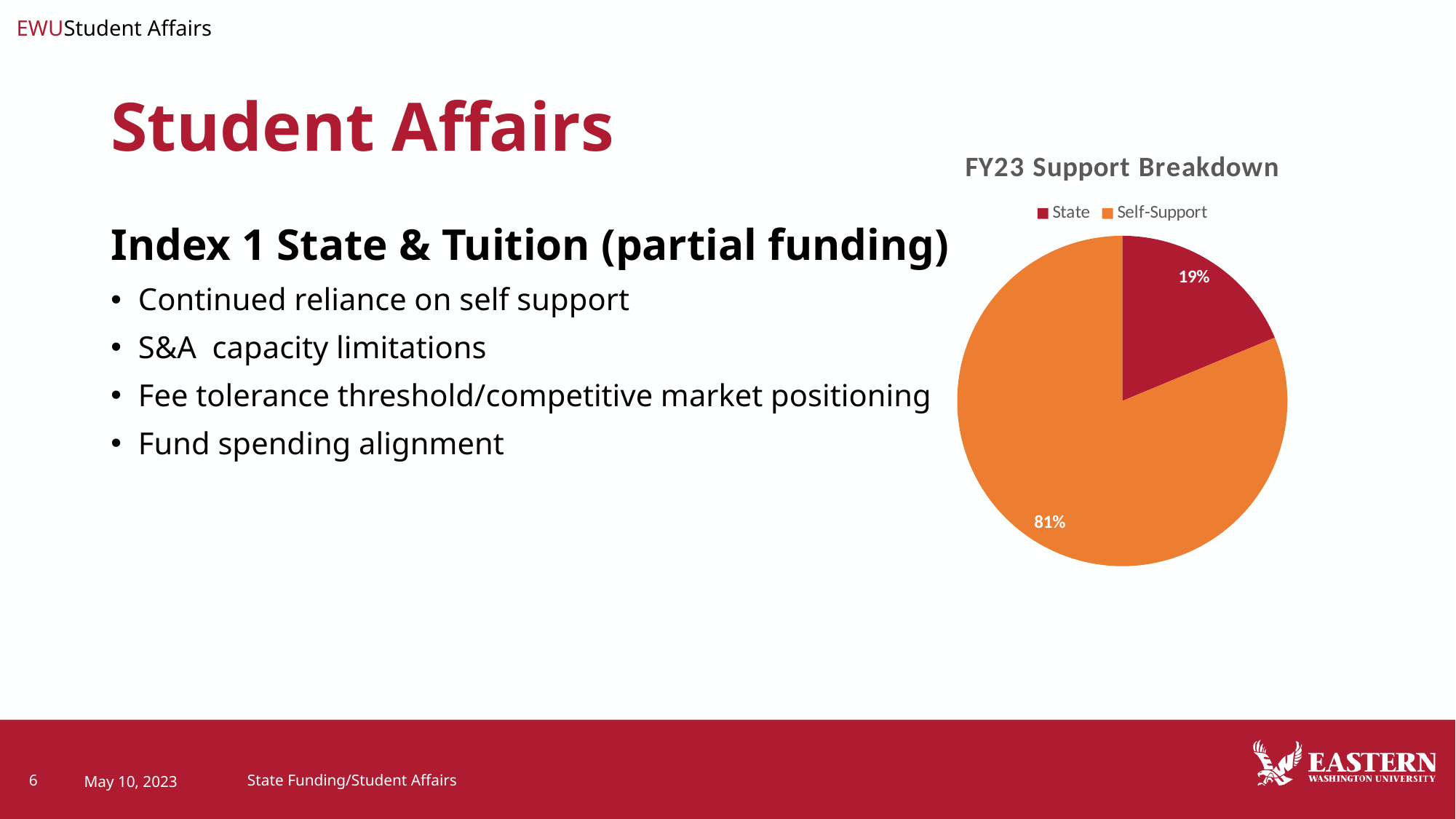
How many entries does the legend of the pie chart list? 2 What share of the FY23 Support Breakdown pie is Self-Support? 81% Which category has the smallest slice in the FY23 Support Breakdown chart? State What colour is the Self-Support slice in the pie chart? Orange What kind of chart is shown on the slide? Pie chart What is the difference in percentage points between the Self-Support and State slices? 62 What share of the FY23 Support Breakdown pie is State? 19% Which category has the largest slice in the FY23 Support Breakdown chart? Self-Support Which is larger in the FY23 Support Breakdown chart, State or Self-Support? Self-Support How many slices does the FY23 Support Breakdown pie chart have? 2 What is the title of the pie chart? FY23 Support Breakdown